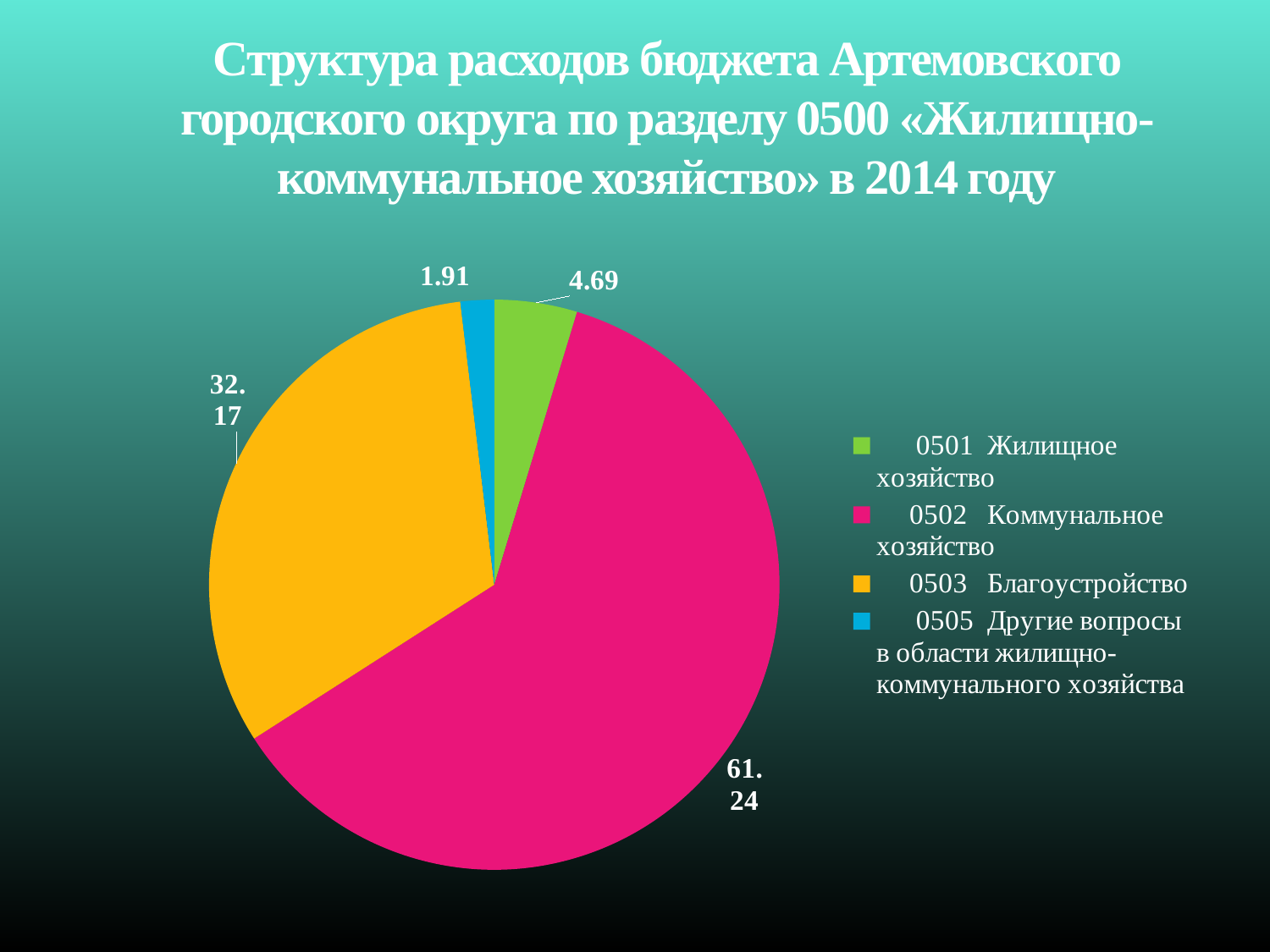
Which category has the largest slice of the pie? 0502 Коммунальное хозяйство Which is larger, the value for 0503 Благоустройство or the value for 0501 Жилищное хозяйство? 0503 Благоустройство What is the difference between the values for 0501 Жилищное хозяйство and 0505 Другие вопросы? 2.78 Which category has the smallest slice of the pie? 0505 Другие вопросы в области жилищно-коммунального хозяйства What is the value shown for 0505 Другие вопросы в области жилищно-коммунального хозяйства? 1.91 What type of chart is shown on the slide? Pie chart What is the value shown for 0501 Жилищное хозяйство? 4.69 How many slices does the pie chart have? 4 What is the difference between the values for 0502 Коммунальное хозяйство and 0503 Благоустройство? 29.07 What is the value shown for 0503 Благоустройство? 32.17 What is the value shown for 0502 Коммунальное хозяйство? 61.24 What colour is the slice for 0503 Благоустройство? Orange